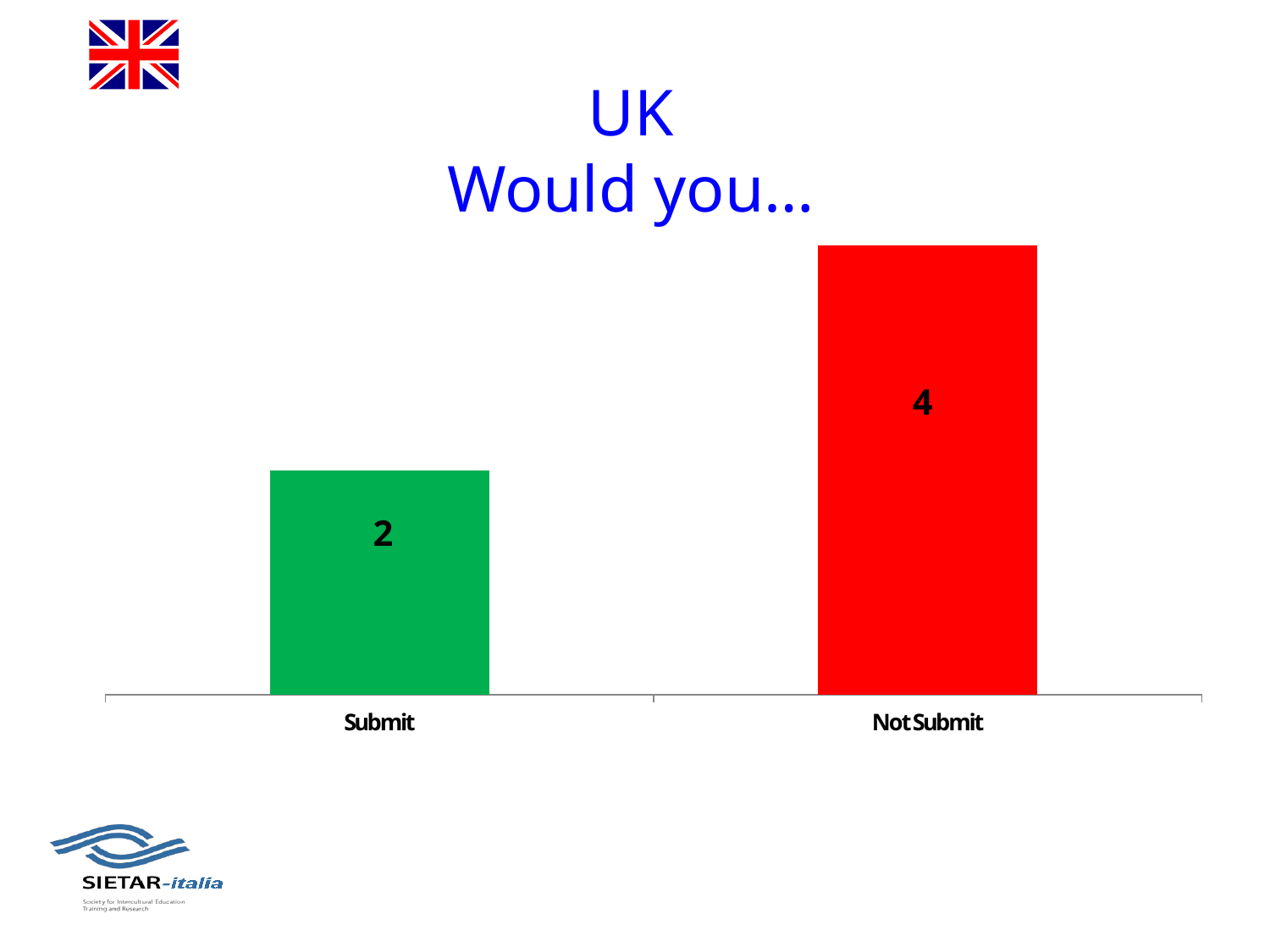
Which category has the highest value? Not Submit What is the value for Not Submit? 4 What is the value for Submit? 2 What is the difference between the values for Not Submit and Submit? 2 What kind of chart is shown on the slide? Bar chart What is the total of the values for Submit and Not Submit? 6 Which category has the lowest value? Submit What colour is the bar for Not Submit? Red How many categories are shown in the chart? 2 What colour is the bar for Submit? Green Which is larger, the value for Submit or the value for Not Submit? Not Submit